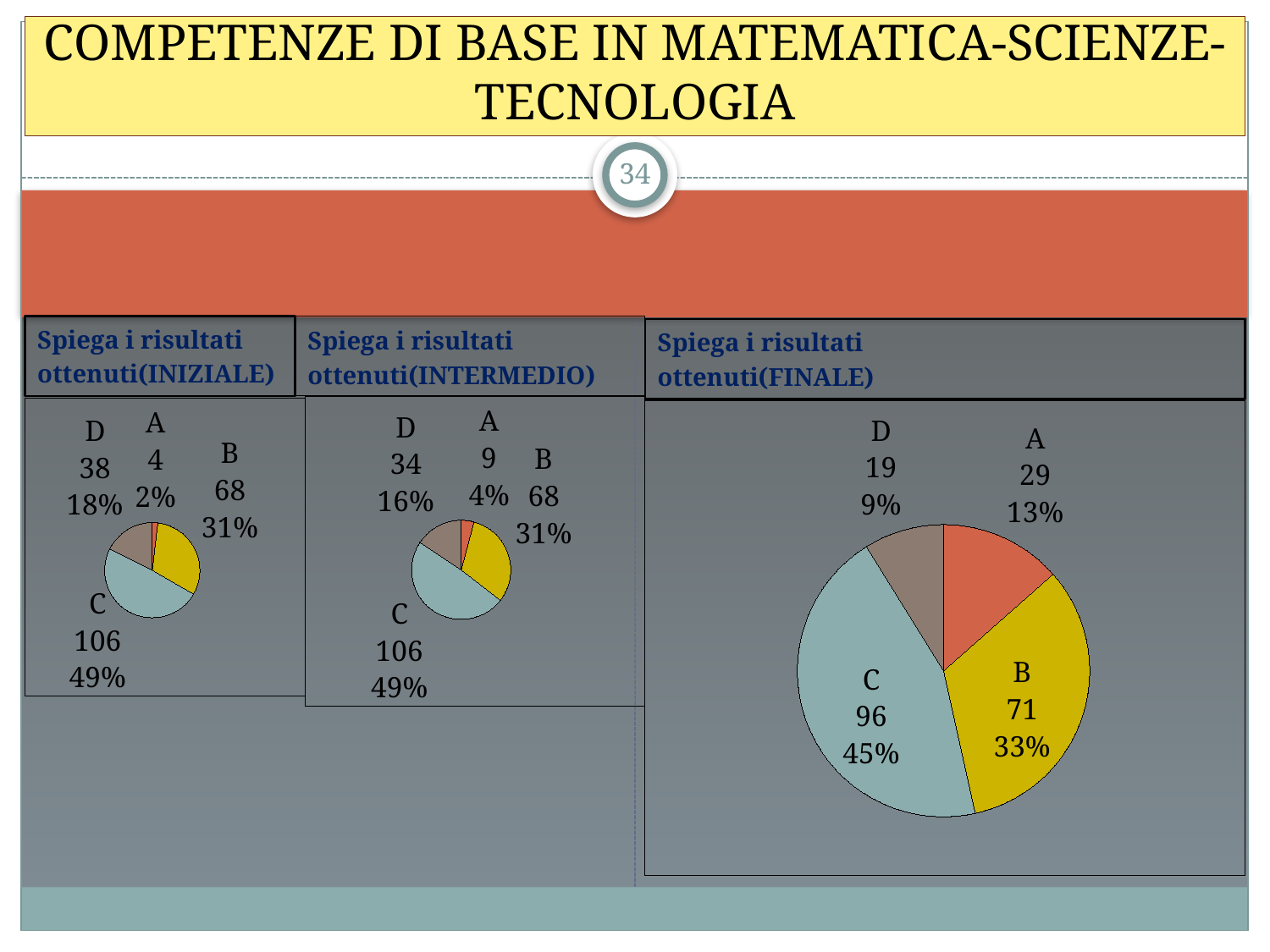
In the 'Spiega i risultati ottenuti(INIZIALE)' pie chart, which is larger, the value for B or the value for D? B In the 'Spiega i risultati ottenuti(INIZIALE)' pie chart, what is the value for category C? 106 How many pie charts are shown on the slide? 3 In the 'Spiega i risultati ottenuti(FINALE)' pie chart, what is the value for category A? 29 In the 'Spiega i risultati ottenuti(FINALE)' pie chart, which category has the smallest slice? D In the 'Spiega i risultati ottenuti(FINALE)' pie chart, what is the difference between the values for C and B? 25 In the 'Spiega i risultati ottenuti(INTERMEDIO)' pie chart, what is the value for category D? 34 What kind of chart is used in the 'Spiega i risultati ottenuti(FINALE)' panel? pie chart In the 'Spiega i risultati ottenuti(FINALE)' pie chart, which category has the largest slice? C How many categories are shown in the 'Spiega i risultati ottenuti(INTERMEDIO)' pie chart? 4 In the 'Spiega i risultati ottenuti(INTERMEDIO)' pie chart, what percentage share does category B have? 31% In the 'Spiega i risultati ottenuti(INIZIALE)' pie chart, what percentage share does category A have? 2%